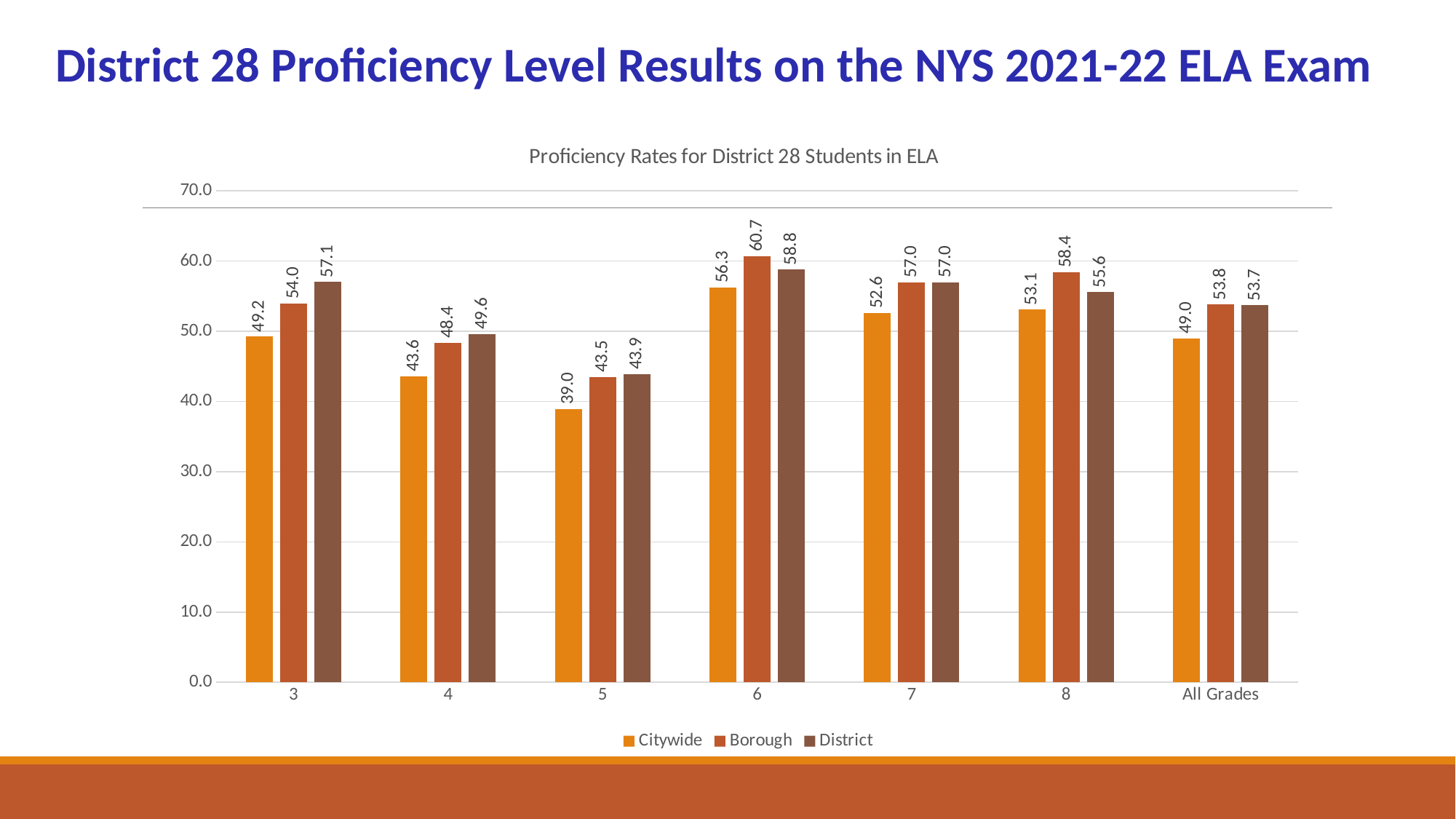
How many series does the legend list? 3 Which is larger for grade 6: the Borough rate or the District rate? Borough Is the Citywide value for grade 4 greater or less than 40.0? greater How many categories are shown on the x axis? 7 Which grade has the lowest Citywide proficiency rate? 5 What is the Citywide proficiency rate for grade 5? 39.0 What is the difference between the District and Citywide proficiency rates for grade 3? 7.9 What is the District proficiency rate for grade 3? 57.1 What is the title of the chart? Proficiency Rates for District 28 Students in ELA Which grade has the highest Borough proficiency rate? 6 What kind of chart is shown on the slide? bar chart What is the Borough proficiency rate for All Grades? 53.8